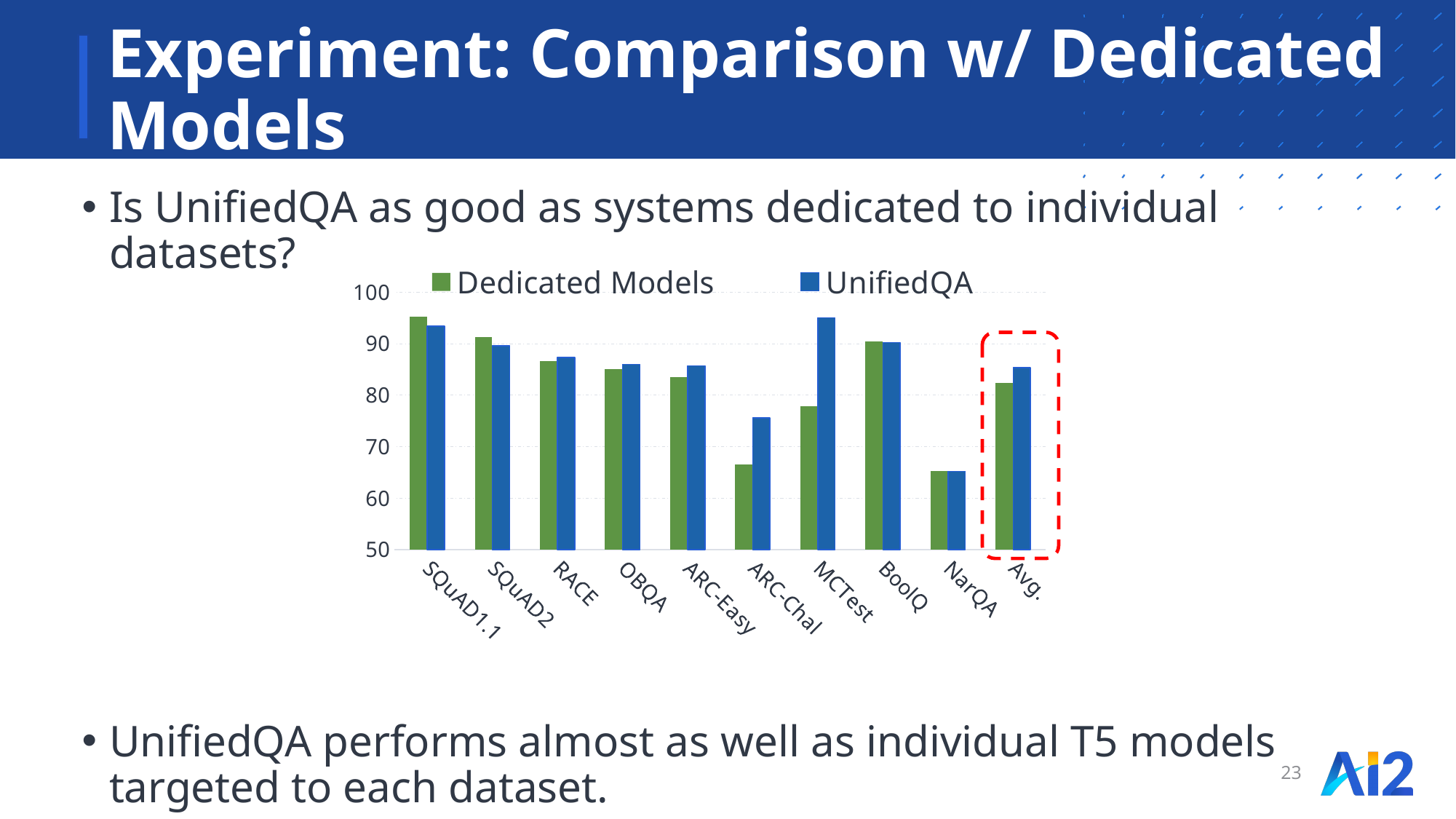
Is the Dedicated Models value for ARC-Chal greater or less than 70? less For which category is the Dedicated Models value highest? SQuAD1.1 How many categories are shown along the x axis of the chart? 10 Which category is highlighted with a red dashed box in the chart? Avg. Which series is shown in green in the chart? Dedicated Models For ARC-Chal, which is larger: the Dedicated Models value or the UnifiedQA value? UnifiedQA Is the UnifiedQA value for MCTest greater or less than 90? greater For which category is the UnifiedQA value lowest? NarQA What kind of chart is shown on the slide? bar chart How many series does the chart's legend list? 2 For Avg., which is larger: the Dedicated Models value or the UnifiedQA value? UnifiedQA For MCTest, which is larger: the Dedicated Models value or the UnifiedQA value? UnifiedQA